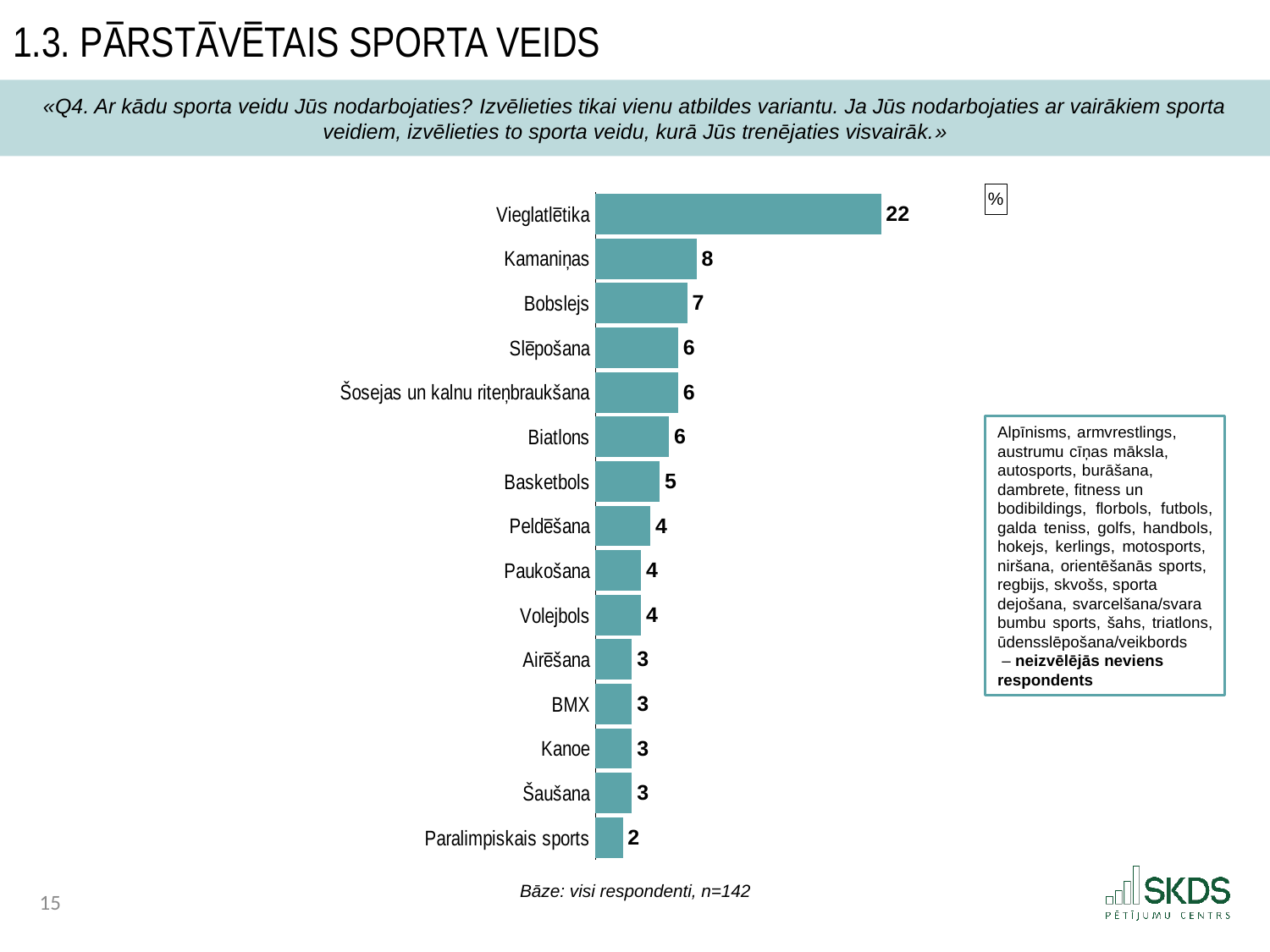
What is the value for Bobslejs? 7 What base (n) is stated below the chart? n=142 What is the value for Paralimpiskais sports? 2 Which is larger, the value for Basketbols or the value for Peldēšana? Basketbols What is the difference between the values for Slēpošana and Paralimpiskais sports? 4 What is the value for Vieglatlētika? 22 What is the difference between the values for Vieglatlētika and Kamaniņas? 14 What kind of chart is shown on the slide? bar chart What is the value for Airēšana? 3 Which category has the lowest value? Paralimpiskais sports Which category has the highest value? Vieglatlētika How many categories are shown in the chart? 15